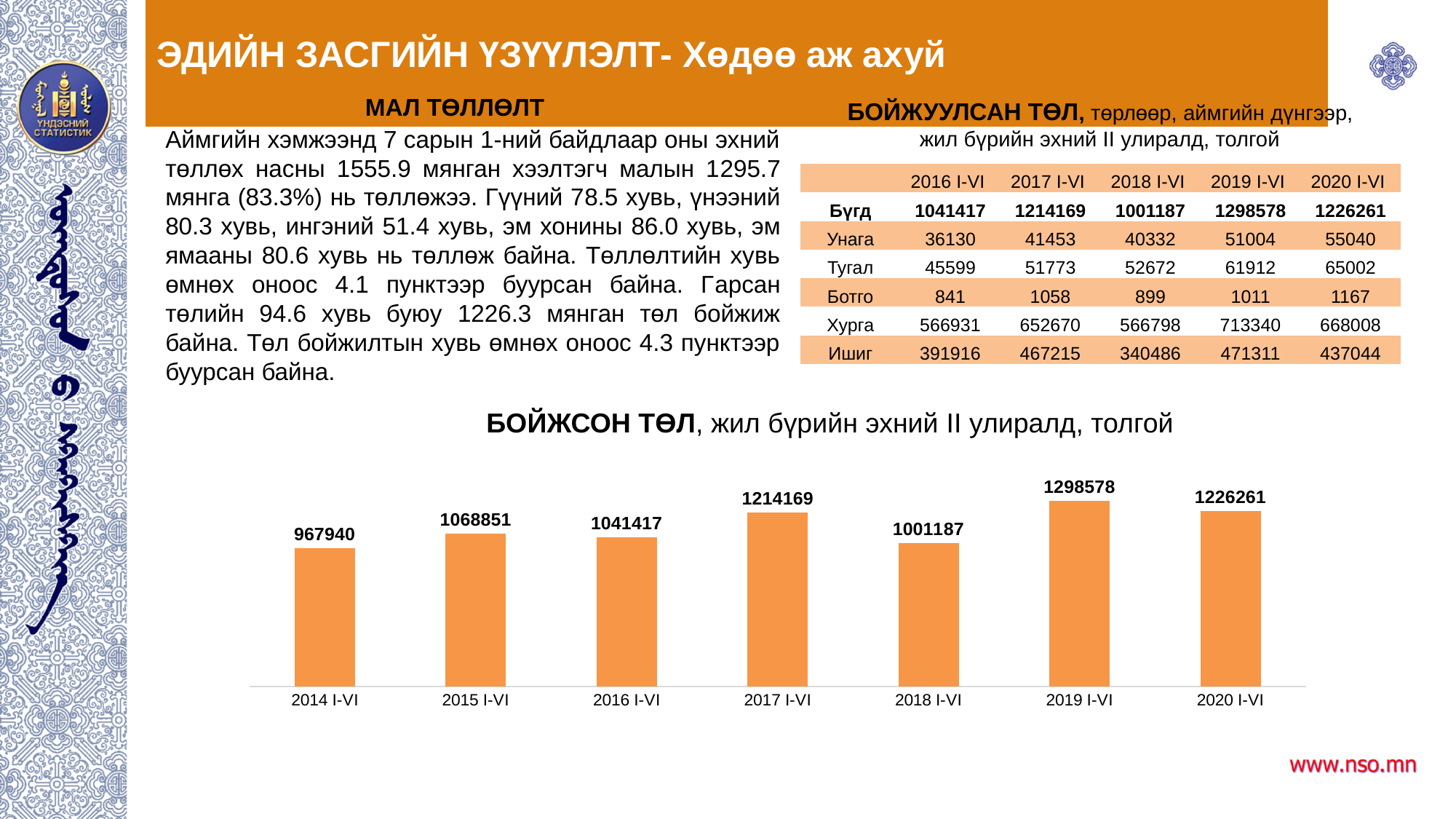
Which period has the highest value in the bar chart? 2019 I-VI What is the difference between the values for 2017 I-VI and 2016 I-VI in the bar chart? 172752 What is the value for 2020 I-VI in the bar chart? 1226261 What is the value for 2014 I-VI in the bar chart? 967940 What kind of chart is shown at the bottom of the slide? Bar chart What is the difference between the values for 2019 I-VI and 2020 I-VI in the bar chart? 72317 How many bars are shown in the bar chart? 7 What is the value for 2017 I-VI in the bar chart? 1214169 Which is larger in the bar chart, the value for 2015 I-VI or 2016 I-VI? 2015 I-VI Did the value rise or fall from 2019 I-VI to 2020 I-VI in the bar chart? Fall Which period has the lowest value in the bar chart? 2014 I-VI What is the value for 2018 I-VI in the bar chart? 1001187